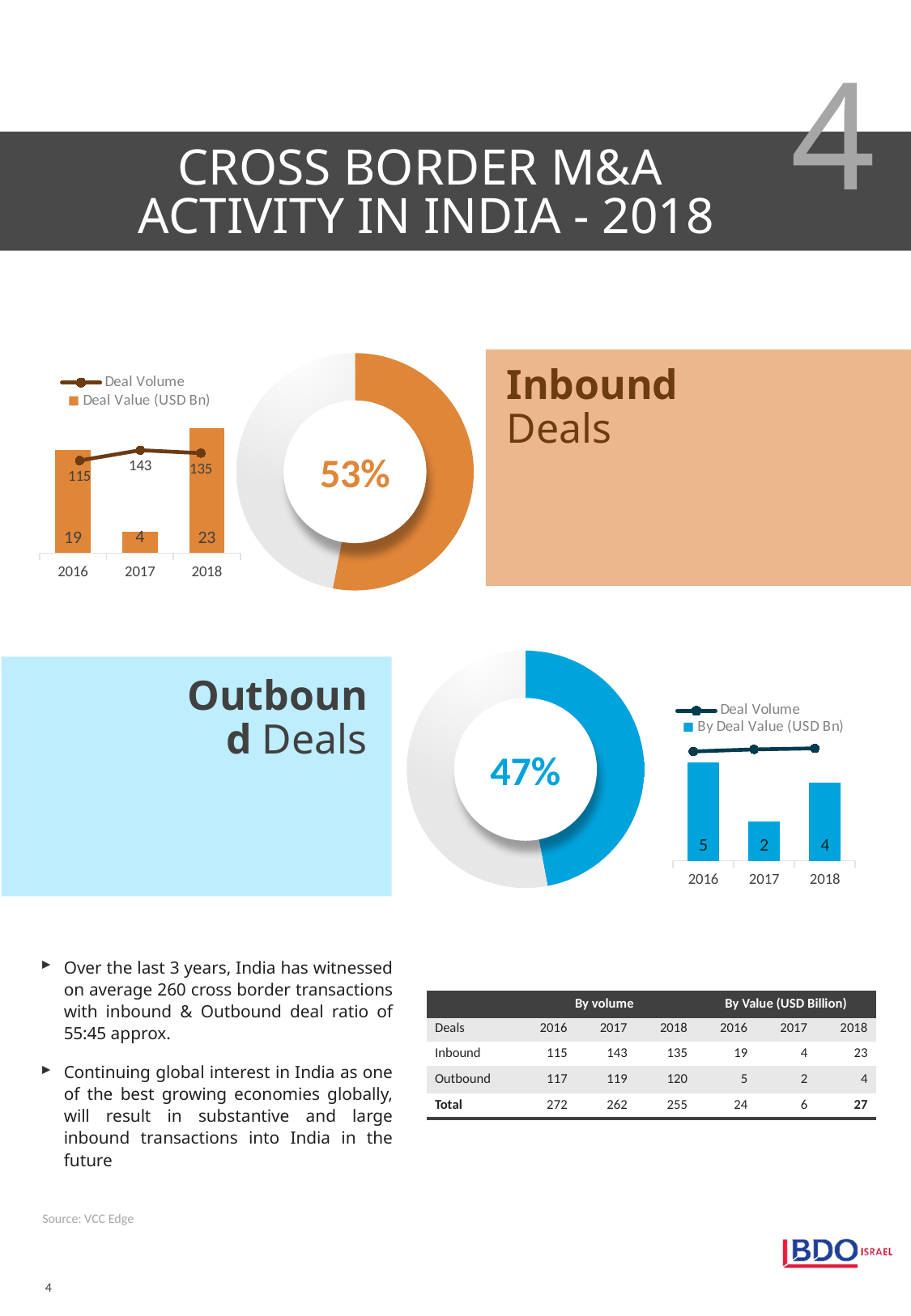
In the Outbound Deals bar chart, what is the By Deal Value (USD Bn) for 2016? 5 In the Inbound Deals chart, which year has the highest Deal Volume? 2017 How many series does the legend of the Outbound Deals bar chart list? 2 What percentage is shown in the Inbound Deals donut chart? 53% In the Outbound Deals bar chart, what is the difference between the Deal Value for 2016 and 2017? 3 In the Inbound Deals chart, what is the difference between the Deal Value for 2018 and 2016? 4 How many years are shown on the x axis of the Inbound Deals bar chart? 3 In the Inbound Deals chart, what is the Deal Volume for 2017? 143 In the Inbound Deals chart, which year has the lowest Deal Value (USD Bn)? 2017 In the Inbound Deals chart, is the Deal Volume for 2016 or 2018 larger? 2018 In the Outbound Deals bar chart, which year has the lowest By Deal Value (USD Bn)? 2017 In the Inbound Deals bar chart, what is the Deal Value (USD Bn) for 2018? 23